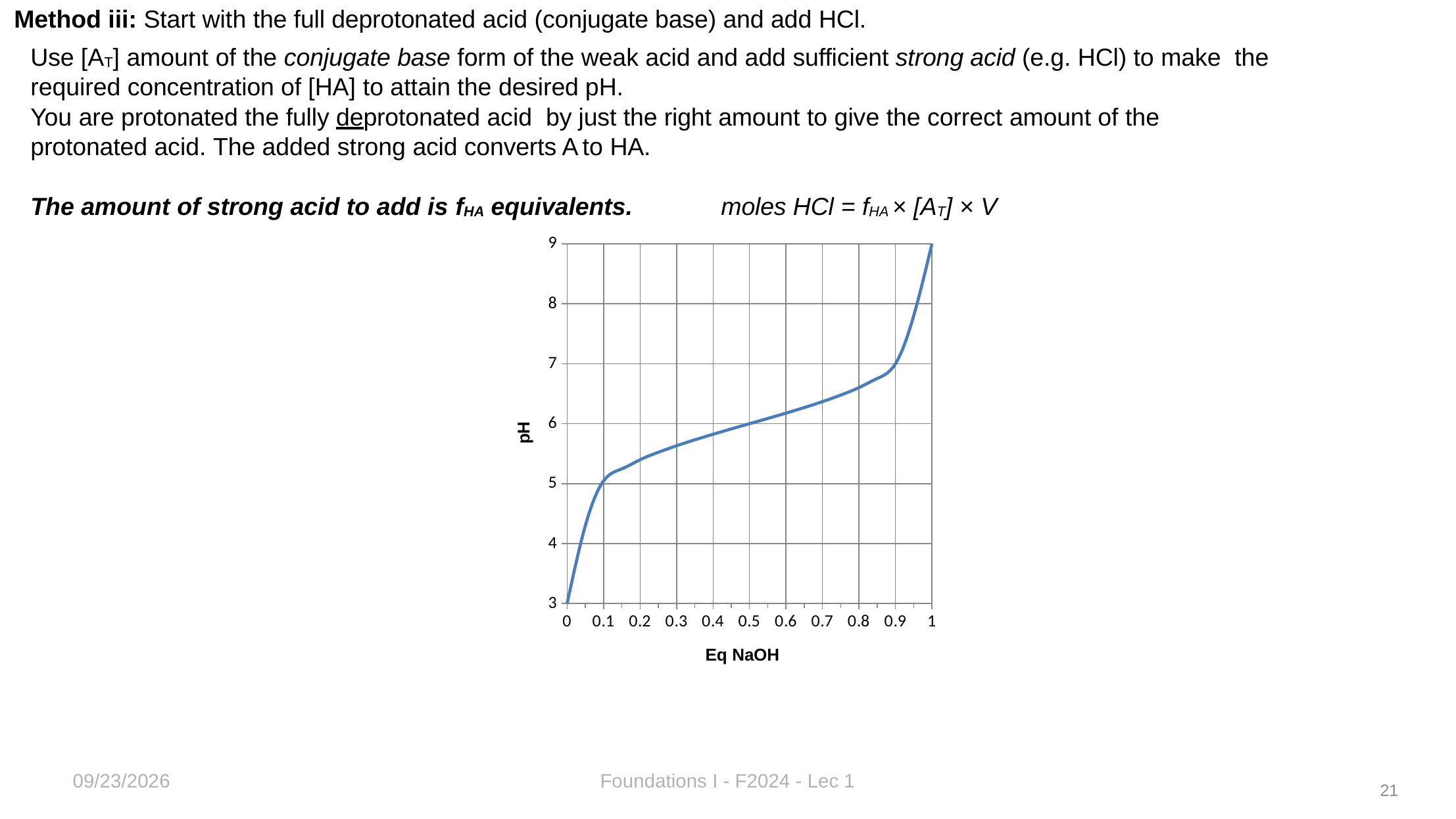
Is the pH at 0.8 Eq NaOH greater or less than 7? less Is the pH at 0.2 Eq NaOH greater or less than 5? greater What is the label of the y axis of the chart? pH What is the pH at 1 Eq NaOH, where the curve ends? 9 Is the pH at 0.7 Eq NaOH greater or less than 6? greater What is the label of the x axis of the chart? Eq NaOH At which Eq NaOH value is the pH highest? 1 What kind of chart is shown on the slide? line chart Which has the higher pH: 0.2 Eq NaOH or 0.8 Eq NaOH? 0.8 Eq NaOH What is the pH at 0 Eq NaOH, where the curve starts? 3 Does the pH rise or fall as Eq NaOH increases from 0 to 1? rise